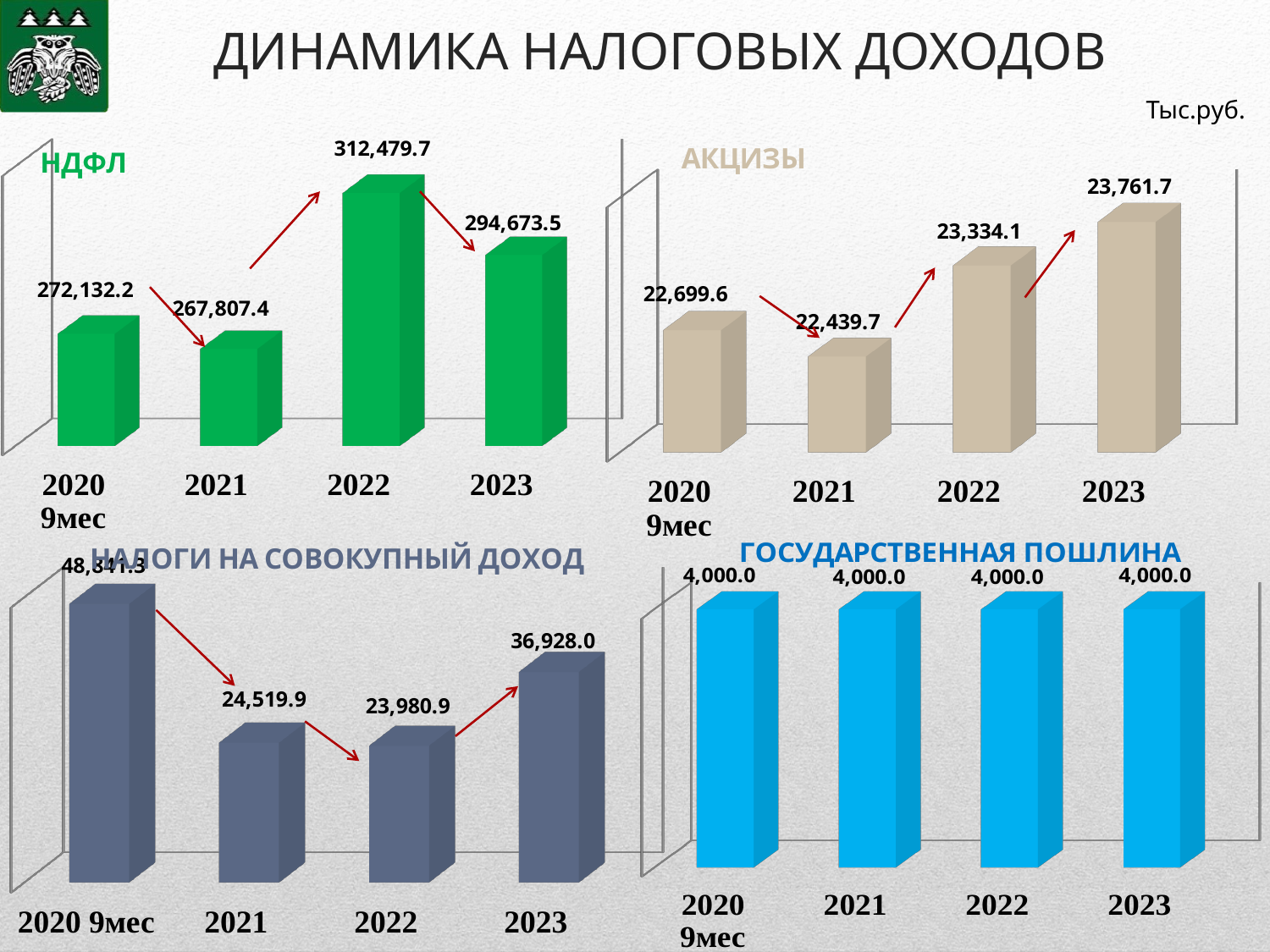
In the АКЦИЗЫ chart, which is larger: the value for 2020 9мес or the value for 2021? 2020 9мес In the АКЦИЗЫ chart, what is the value for 2023? 23,761.7 In the АКЦИЗЫ chart, which year has the highest value? 2023 In the НДФЛ chart, which year has the lowest value? 2021 What kind of chart is the НДФЛ chart? bar chart In the НДФЛ chart, what is the value for 2022? 312,479.7 How many categories (years) are shown in the АКЦИЗЫ chart? 4 In the НАЛОГИ НА СОВОКУПНЫЙ ДОХОД chart, what is the value for 2023? 36,928.0 In the НАЛОГИ НА СОВОКУПНЫЙ ДОХОД chart, what is the difference between the 2021 and 2022 values? 539.0 In the ГОСУДАРСТВЕННАЯ ПОШЛИНА chart, what is the value for 2021? 4,000.0 In the ГОСУДАРСТВЕННАЯ ПОШЛИНА chart, do the values rise, fall or stay the same from 2020 9мес to 2023? stay the same In the НДФЛ chart, what is the difference between the 2022 and 2023 values? 17,806.2